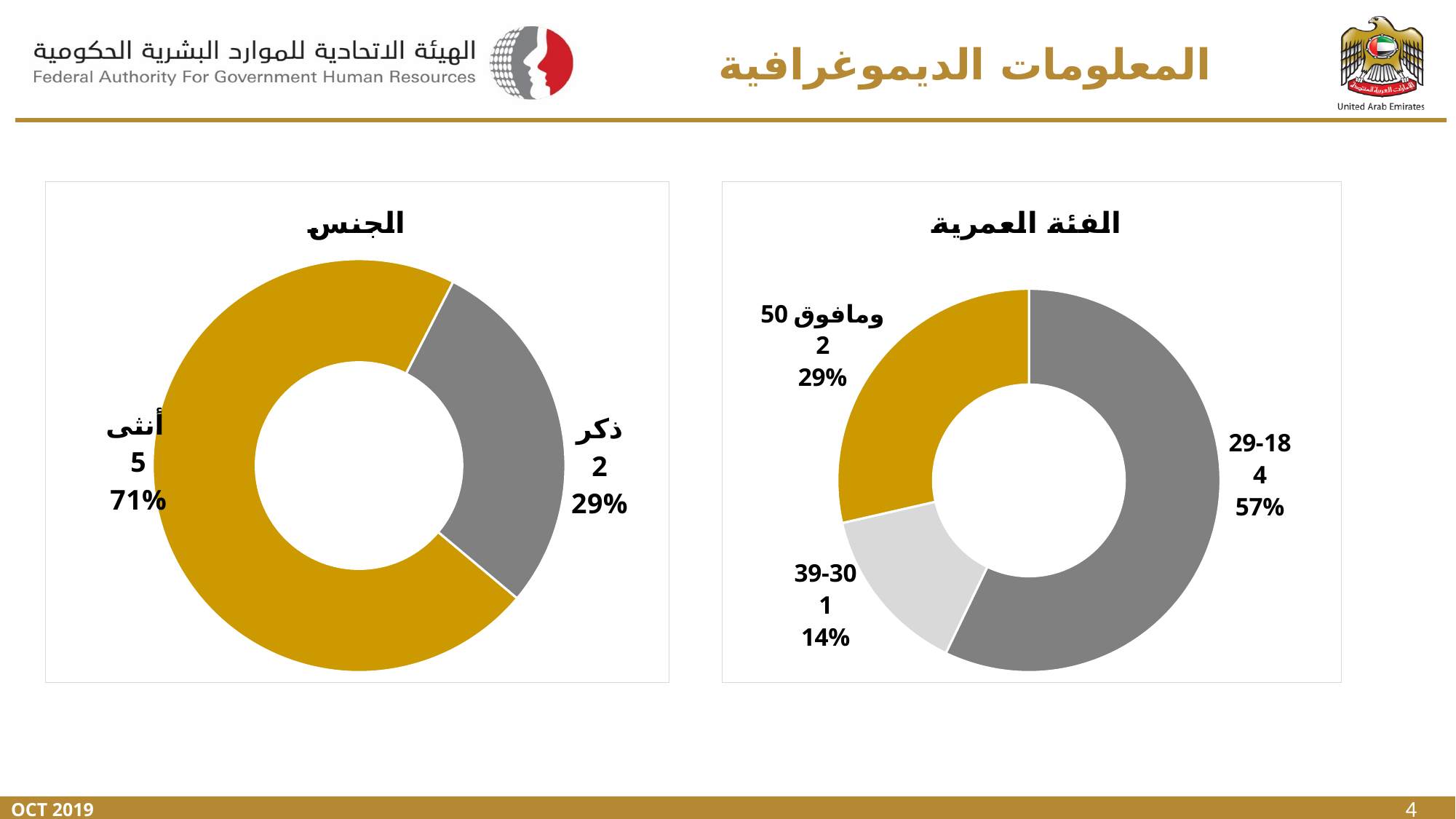
In the chart titled "الجنس", which category has the larger share? أنثى How many age groups are shown in the chart titled "الفئة العمرية"? 3 In the chart titled "الجنس", what is the difference between the counts for أنثى and ذكر? 3 In the chart titled "الفئة العمرية", which age group has the smallest share? 39-30 In the chart titled "الفئة العمرية", which age group has the largest share? 29-18 In the chart titled "الفئة العمرية", what percentage is shown for the 39-30 group? 14% In the chart titled "الفئة العمرية", which is larger: the count for 29-18 or the count for 50 ومافوق? 29-18 In the chart titled "الفئة العمرية", what is the count for the 50 ومافوق group? 2 In the chart titled "الجنس", what percentage is shown for ذكر? 29% In the chart titled "الفئة العمرية", what is the count for the 29-18 group? 4 What kind of chart is the chart titled "الجنس"? Doughnut chart In the chart titled "الجنس", what is the count for أنثى? 5